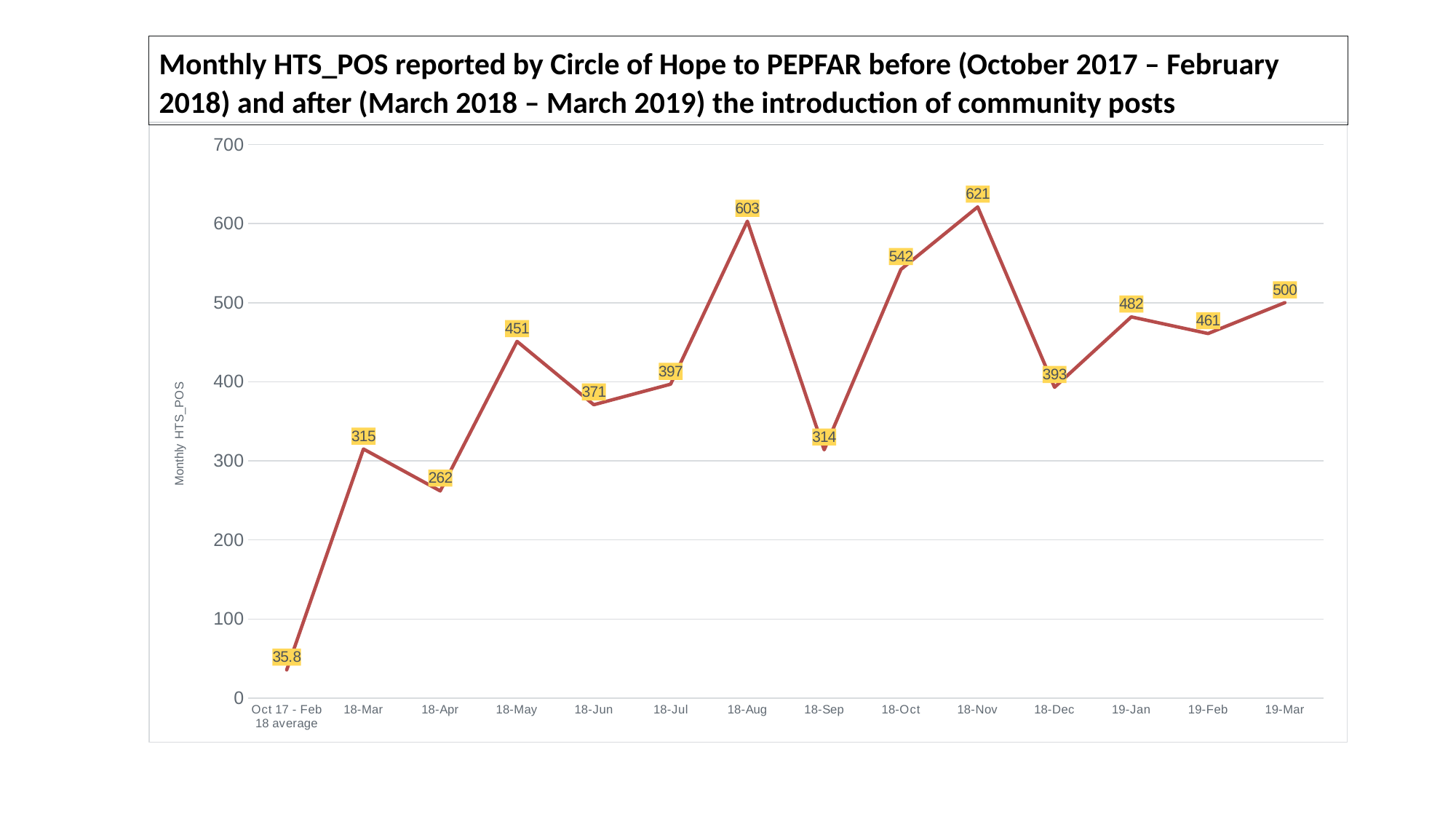
What is the difference between the values for 18-Nov and 18-Dec? 228 What is the Monthly HTS_POS value for 18-Aug? 603 How many data points are plotted on the chart? 14 Which is larger, the value for 18-May or the value for 18-Jun? 18-May What kind of chart is shown on the slide? line chart Does the value rise or fall from 18-Aug to 18-Sep? fall Is the value for 18-Oct greater or less than 500? greater What is the label on the vertical axis of the chart? Monthly HTS_POS Which month has the highest Monthly HTS_POS value? 18-Nov What is the Monthly HTS_POS value for the Oct 17 - Feb 18 average? 35.8 What is the Monthly HTS_POS value for 19-Mar? 500 Which point on the chart has the lowest value? Oct 17 - Feb 18 average